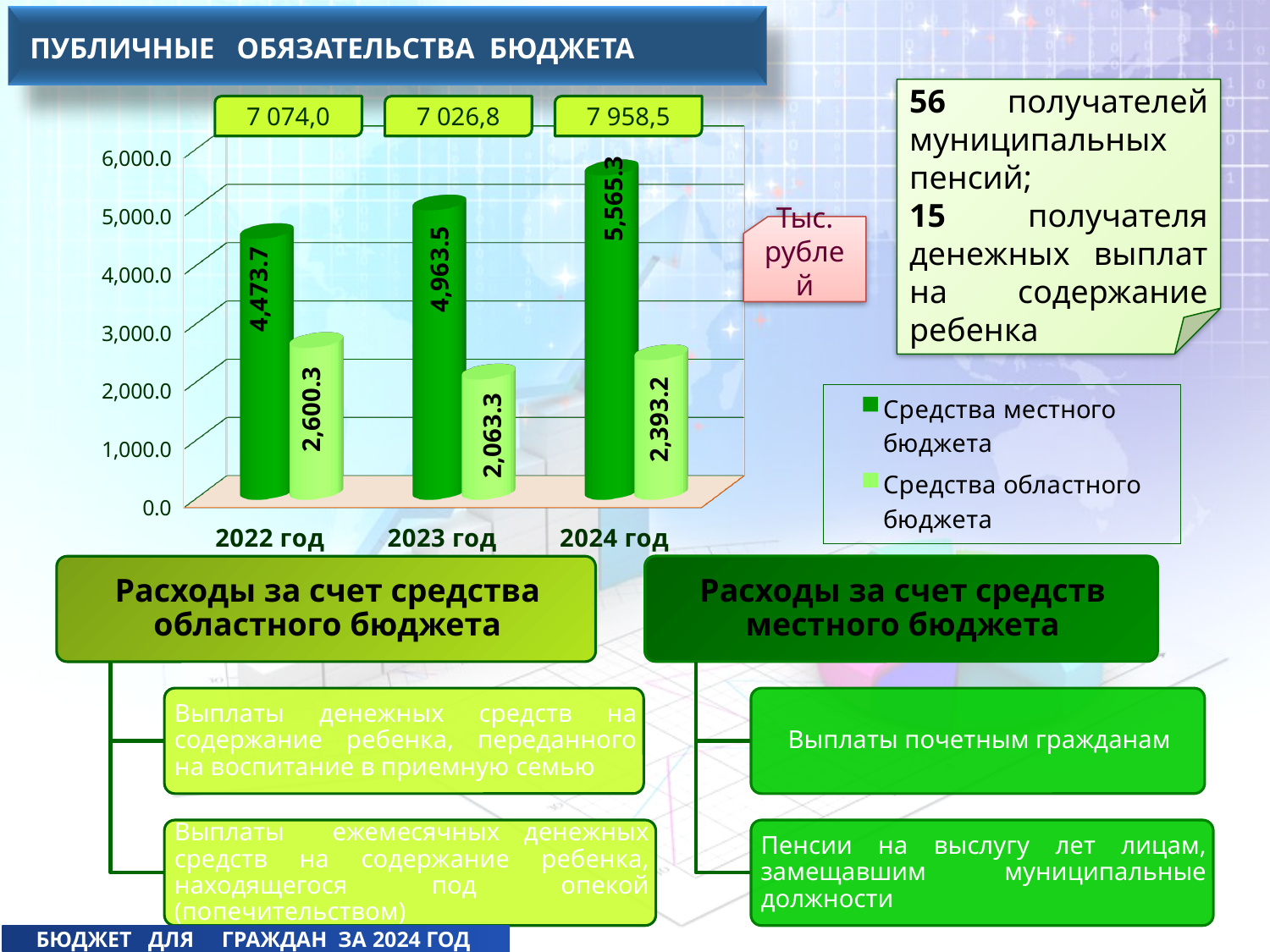
How many years are shown on the x axis of the chart? 3 What is the value for Средства областного бюджета in 2024 год? 2,393.2 In which year is Средства областного бюджета the lowest? 2023 год How many series does the chart legend list? 2 What is the value for Средства местного бюджета in 2022 год? 4,473.7 Is the value for Средства местного бюджета in 2023 год greater or less than 4,000.0? greater What is the difference between Средства местного бюджета and Средства областного бюджета in 2022 год? 1,873.4 Does Средства местного бюджета rise or fall from 2022 год to 2024 год? rise Which is larger in 2023 год: Средства местного бюджета or Средства областного бюджета? Средства местного бюджета What is the value for Средства областного бюджета in 2023 год? 2,063.3 In which year is Средства местного бюджета the highest? 2024 год What is the value for Средства местного бюджета in 2024 год? 5,565.3